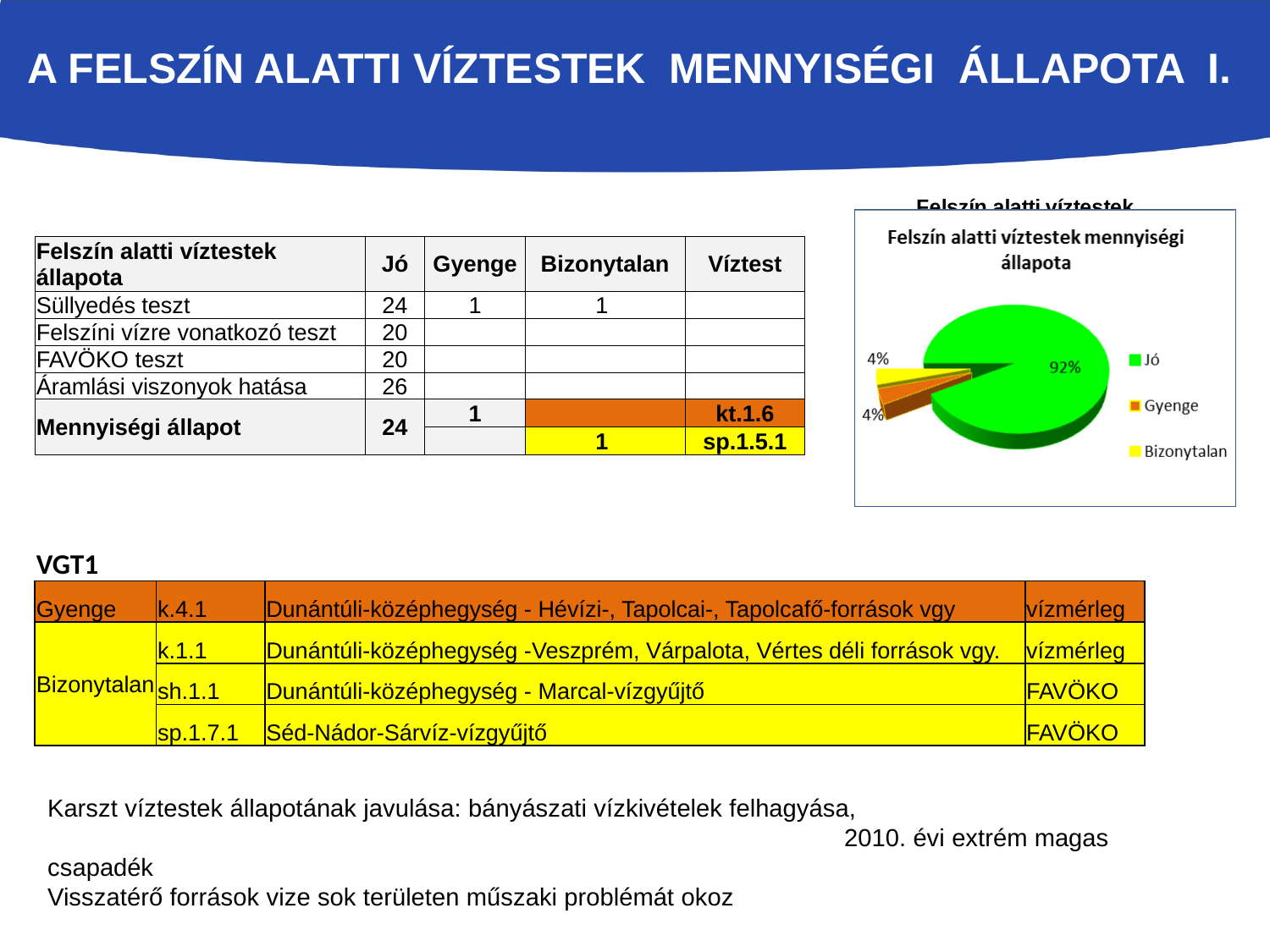
What colour is the Jó slice in the pie chart? green How many categories does the legend of the pie chart list? 3 What share of the pie does the Jó slice represent? 92% What share of the pie does the Gyenge slice represent? 4% What share of the pie does the Bizonytalan slice represent? 4% What kind of chart is shown on the slide? pie chart What is the difference in percentage points between the Jó slice and the Bizonytalan slice? 88 How many slices does the pie chart have? 3 Which is larger in the pie chart, the Jó slice or the Gyenge slice? Jó Which category has the largest slice of the pie? Jó What is the title of the pie chart? Felszín alatti víztestek mennyiségi állapota